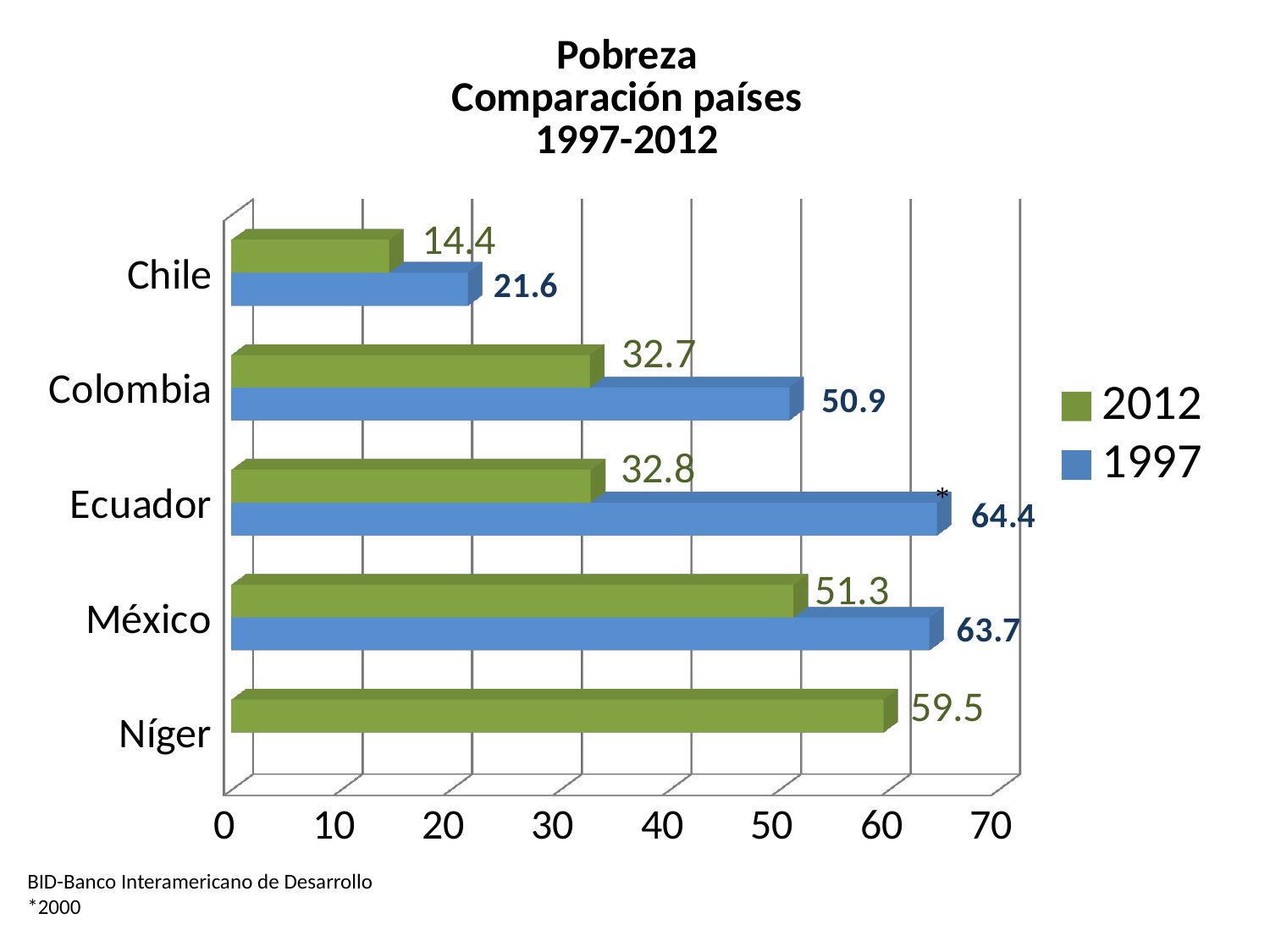
Which is larger, the 2012 value for Colombia or the 2012 value for México? México Is the 1997 value for Colombia greater or less than 40? greater Which country has no 1997 bar shown? Níger How many series does the legend list? 2 Which country has the lowest 1997 value? Chile What is the difference between the 1997 and 2012 values for México? 12.4 How many countries are shown on the chart? 5 What is the 1997 poverty value for Ecuador? 64.4 What kind of chart is shown? bar chart Which country has the highest 2012 value? Níger What is the 2012 value for Níger? 59.5 What is the 2012 poverty value for Chile? 14.4